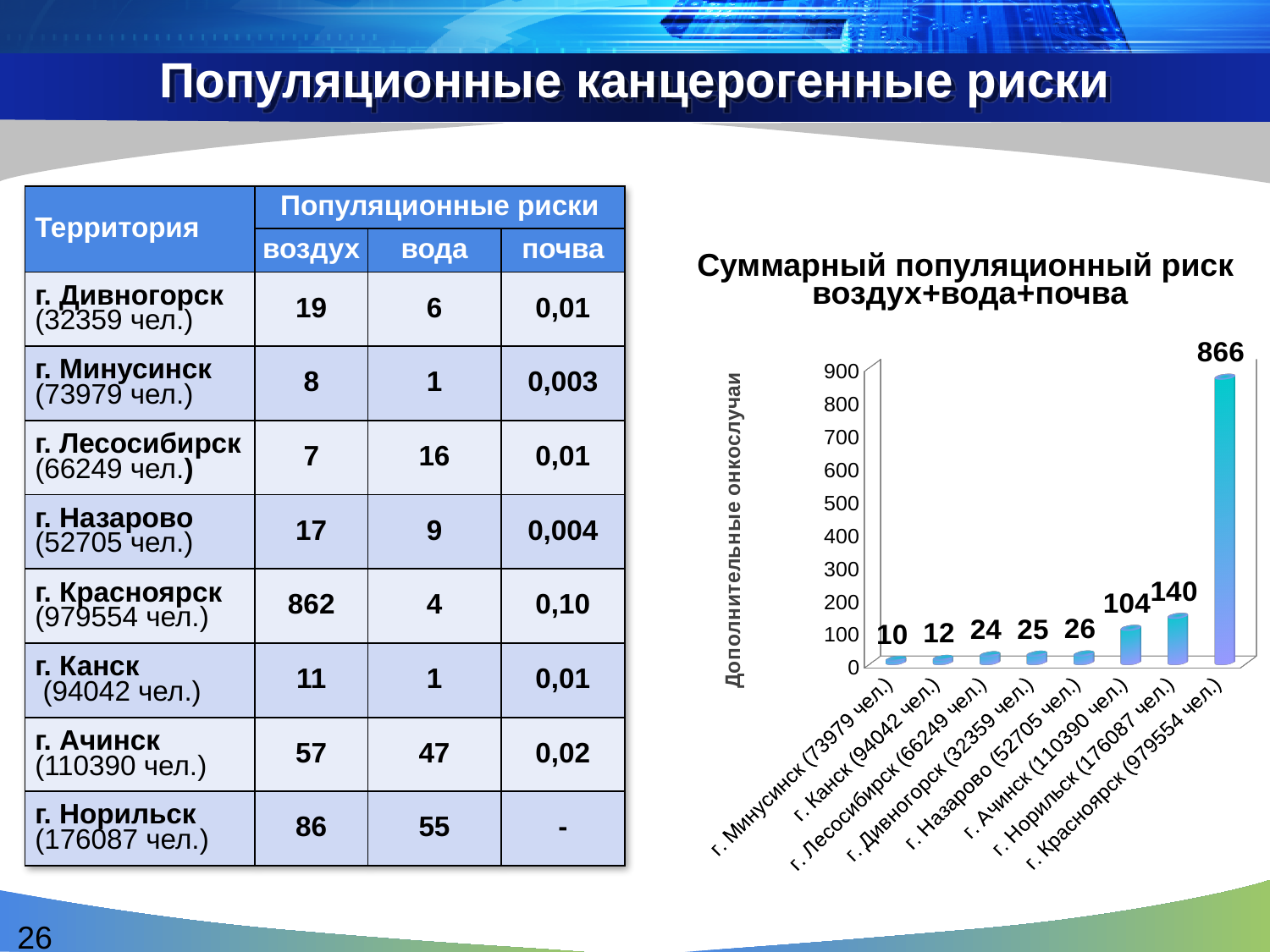
What is the label of the vertical axis of the chart? Дополнительные онкослучаи What is the title of the chart? Суммарный популяционный риск воздух+вода+почва What is the value for г. Ачинск in the chart? 104 What is the value for г. Норильск in the chart? 140 What is the value for г. Минусинск in the chart? 10 Which city has the highest value in the chart? г. Красноярск What is the difference between the values for г. Норильск and г. Ачинск in the chart? 36 What type of chart is shown on the slide? bar chart How many cities are shown in the chart? 8 Which city has the lowest value in the chart? г. Минусинск What is the value for г. Красноярск in the chart? 866 Which has a larger value in the chart, г. Лесосибирск or г. Назарово? г. Назарово